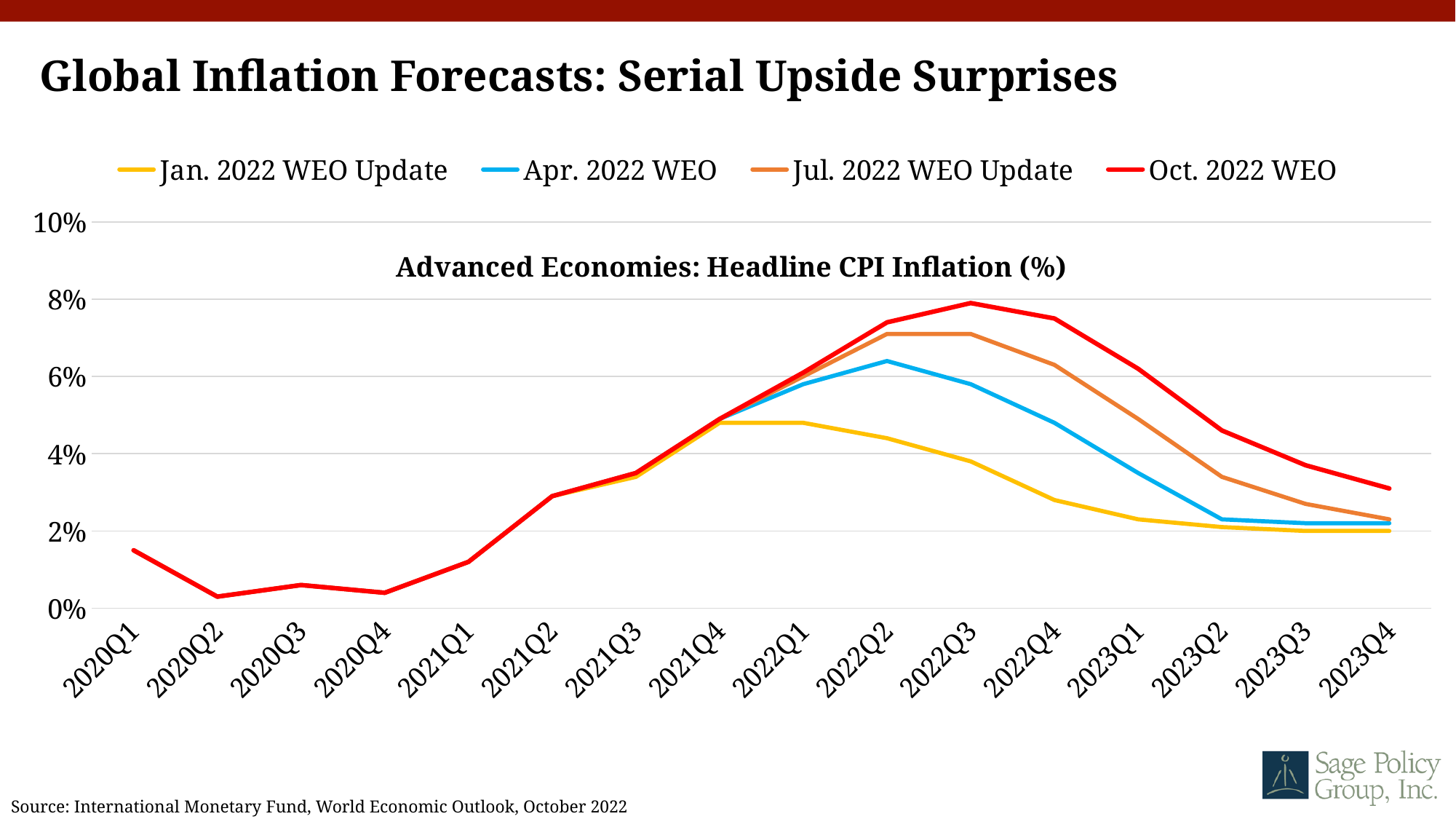
Which series reaches the highest peak on the chart? Oct. 2022 WEO What is the subtitle printed inside the chart area? Advanced Economies: Headline CPI Inflation (%) Does the Oct. 2022 WEO line rise or fall from 2022Q3 to 2023Q4? fall Is the value for Jan. 2022 WEO Update at 2022Q4 greater or less than 4%? less What kind of chart is shown on the slide? line chart In which quarter does the Oct. 2022 WEO line reach its highest value? 2022Q3 At 2022Q4, which is higher: Jul. 2022 WEO Update or Apr. 2022 WEO? Jul. 2022 WEO Update Is the value for Oct. 2022 WEO at 2022Q3 greater or less than 6%? greater Is the value for Jul. 2022 WEO Update at 2022Q2 greater or less than 6%? greater How many quarters are shown along the x axis? 16 In which quarter does the plotted line reach its lowest value? 2020Q2 How many series does the legend list? 4